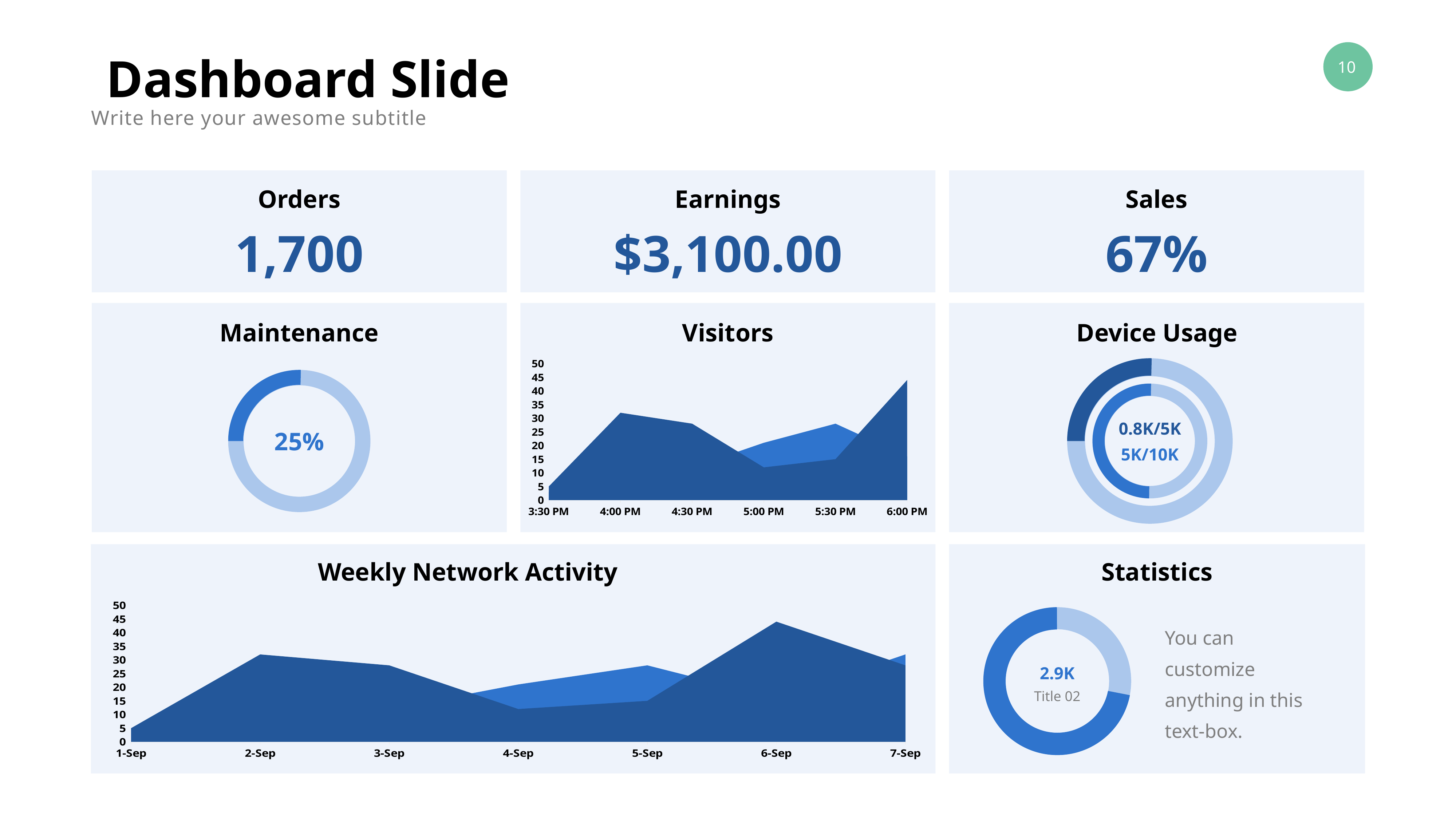
What is the first value printed in the centre of the Device Usage chart? 0.8K/5K In the Weekly Network Activity chart, on which date does the plotted area reach its highest point? 6-Sep How many dates are labelled on the x axis of the Weekly Network Activity chart? 7 What is the title of the chart in the bottom-left panel of the slide? Weekly Network Activity How many time points are labelled on the x axis of the Visitors chart? 6 What kind of chart is the Visitors chart? area chart What is the second value printed in the centre of the Device Usage chart? 5K/10K What percentage is shown in the centre of the Maintenance donut chart? 25% In the Visitors chart, is the value at 3:30 PM greater or less than 10? less In the Visitors chart, at which time does the plotted area reach its highest point? 6:00 PM What value is shown in the centre of the Statistics donut chart? 2.9K In the Weekly Network Activity chart, is the value at 6-Sep greater or less than 40? greater